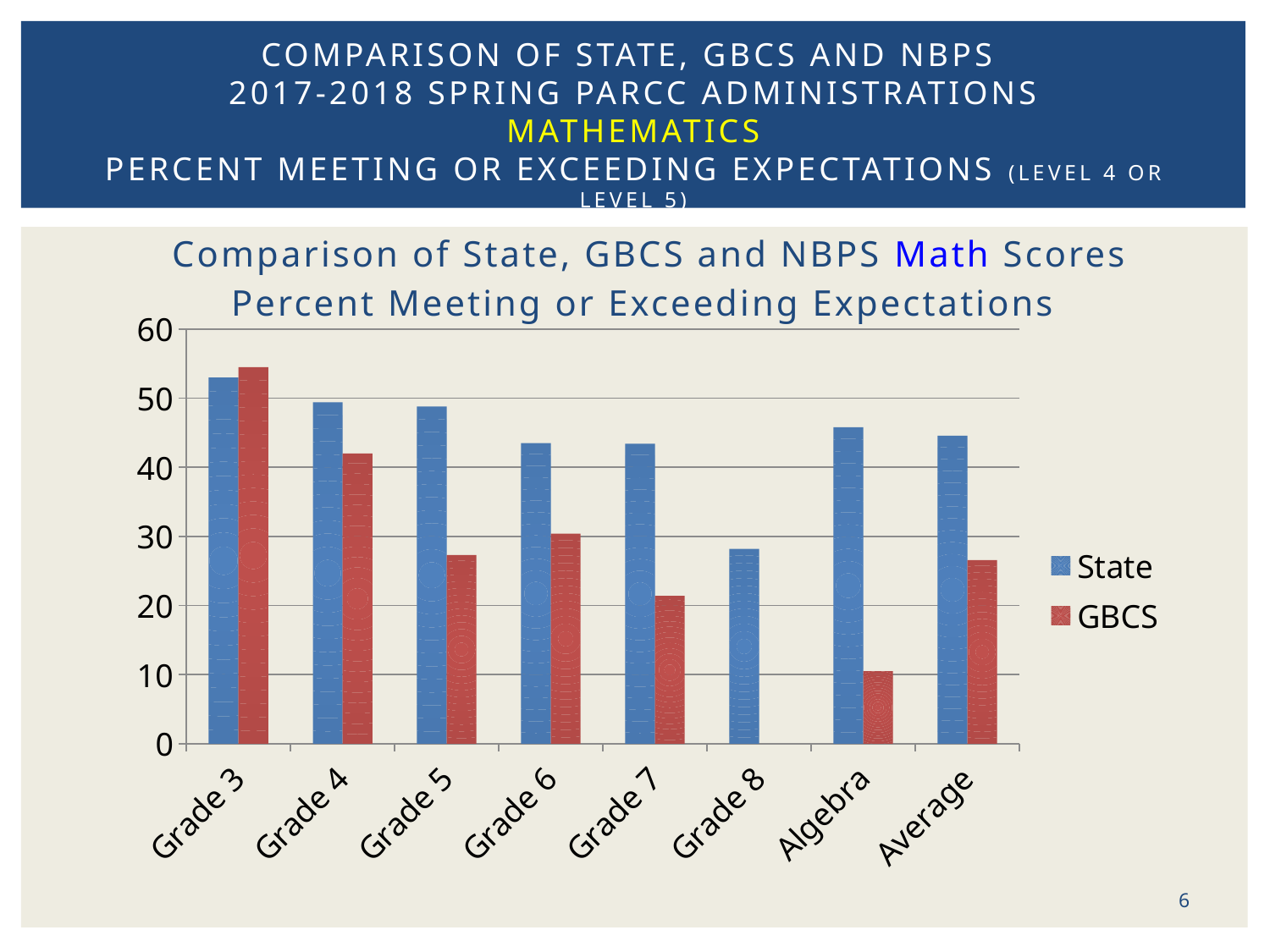
Which category has the highest State value? Grade 3 For Grade 4, which is larger, the State value or the GBCS value? State How many series does the legend list? 2 Which category has the lowest State value? Grade 8 Which category has the lowest GBCS value among those with a GBCS bar? Algebra Is the State value for Grade 3 greater or less than 50? greater Is the GBCS value for Algebra greater or less than 20? less How many categories are shown on the x axis? 8 Which category has the highest GBCS value? Grade 3 Which category has no GBCS bar? Grade 8 Is the State value for Grade 8 greater or less than 30? less What kind of chart is shown on the slide? bar chart